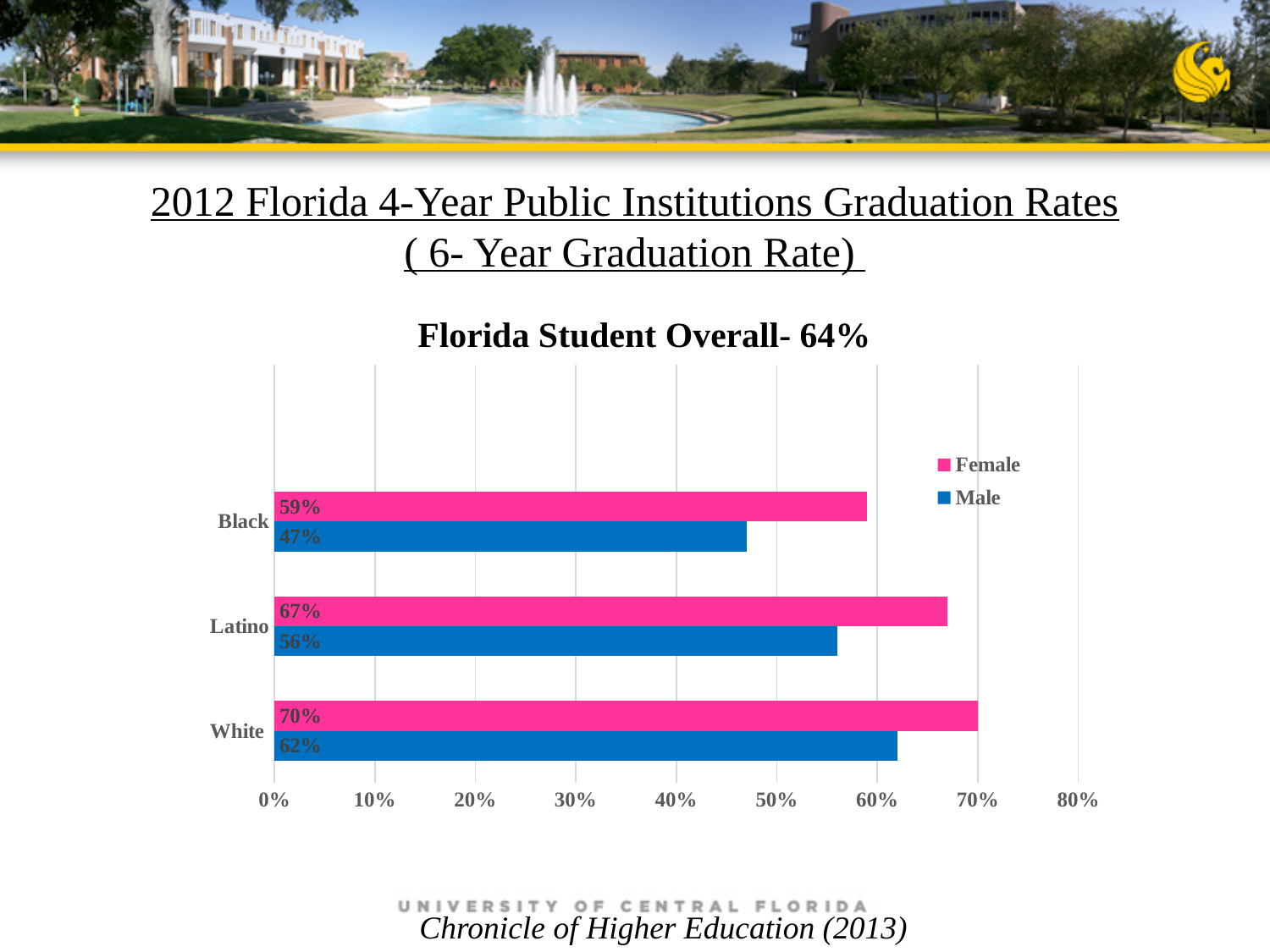
Which category has the highest Female graduation rate? White How many categories are shown on the chart? 3 What is the difference between the Female and Male graduation rates for Black students? 12% What is the difference between the Female graduation rates for White and Latino students? 3% Which is larger, the Male rate for White students or the Female rate for Black students? Male rate for White students What is the Female graduation rate for Black students? 59% What is the Male graduation rate for Latino students? 56% What kind of chart is shown on the slide? Bar chart Which category has the lowest Male graduation rate? Black What is the Male graduation rate for White students? 62% How many series does the legend list? 2 What is the chart's title? Florida Student Overall- 64%